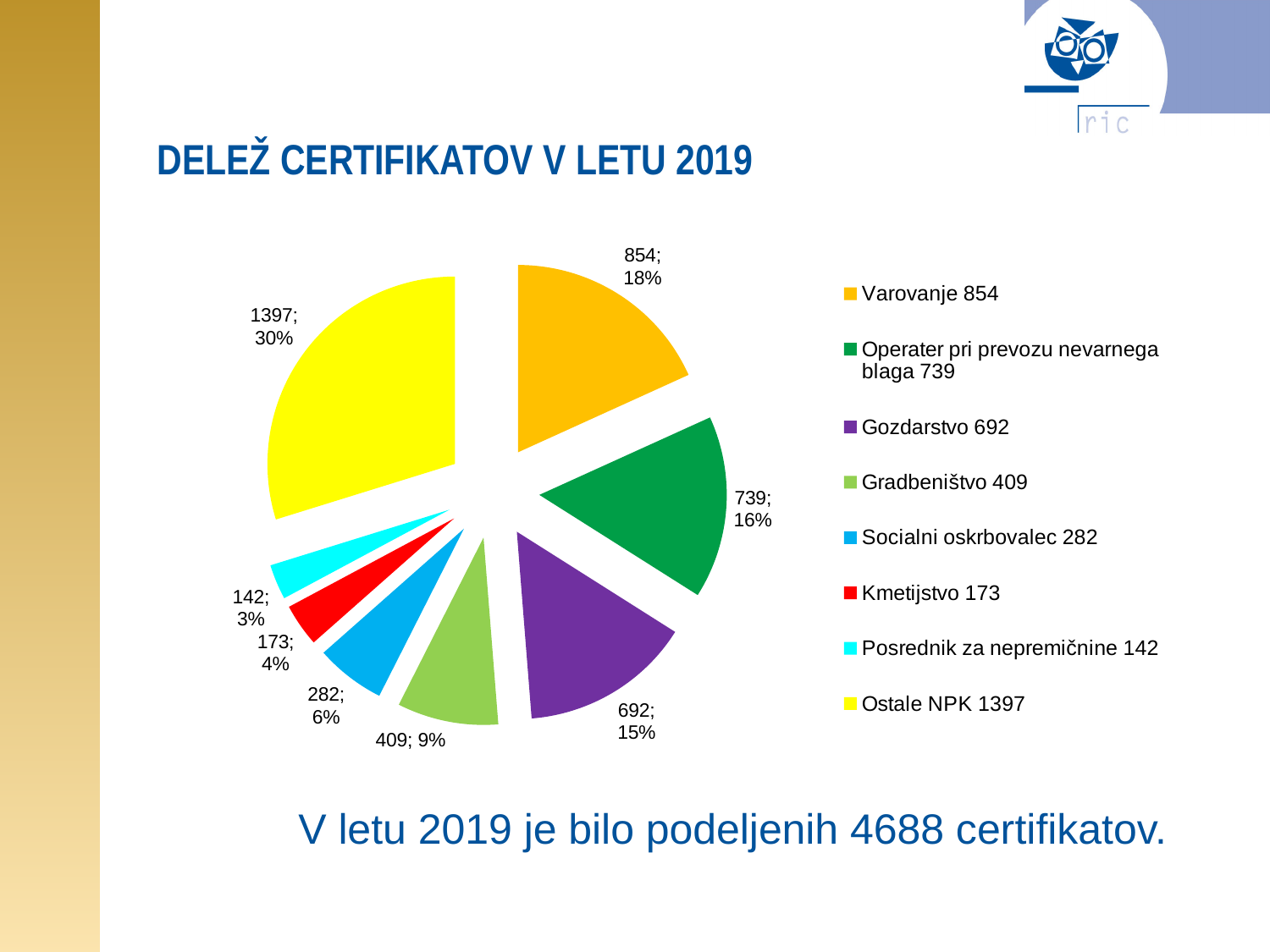
Which is larger, Gradbeništvo or Kmetijstvo? Gradbeništvo What is the title of the chart? DELEŽ CERTIFIKATOV V LETU 2019 What colour is the slice for Kmetijstvo? red Which category has the largest slice? Ostale NPK What percentage share does Ostale NPK have? 30% What kind of chart is shown on the slide? pie chart What percentage share does Gozdarstvo have? 15% What is the difference between the values for Varovanje and Operater pri prevozu nevarnega blaga? 115 Which category has the smallest slice? Posrednik za nepremičnine What is the value for Varovanje? 854 What is the value for Socialni oskrbovalec? 282 How many slices does the pie chart have? 8